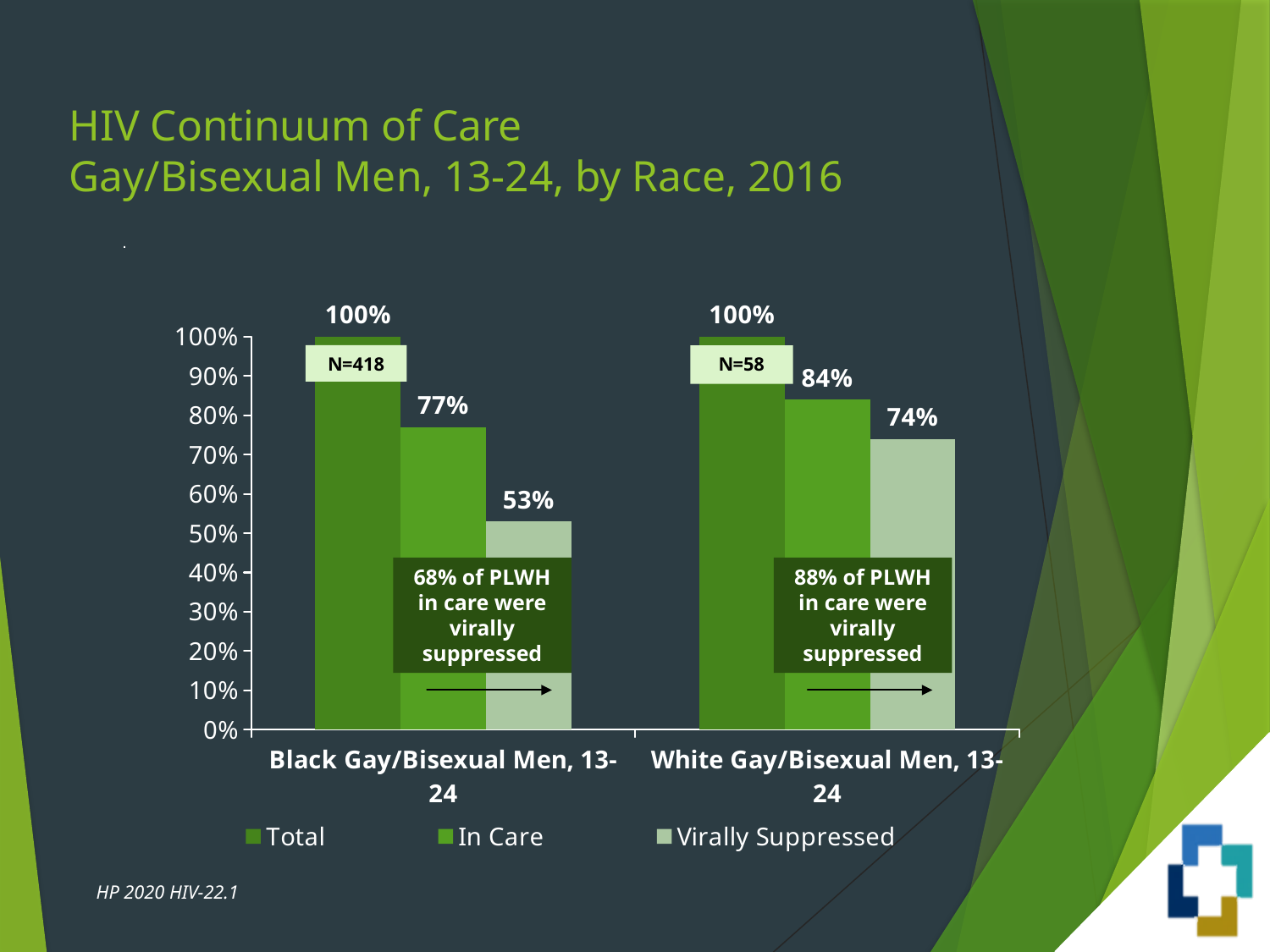
Which group has the higher Virally Suppressed value, Black or White Gay/Bisexual Men, 13-24? White Gay/Bisexual Men, 13-24 What is the N shown for Black Gay/Bisexual Men, 13-24? N=418 How many series does the legend list? 3 What is the In Care value for White Gay/Bisexual Men, 13-24? 84% What is the In Care value for Black Gay/Bisexual Men, 13-24? 77% What is the difference between the In Care values for White and Black Gay/Bisexual Men, 13-24? 7% How many categories are shown on the x axis? 2 According to the annotation, what percentage of PLWH in care were virally suppressed among White Gay/Bisexual Men, 13-24? 88% What kind of chart is shown on the slide? Bar chart What is the difference between the In Care and Virally Suppressed values for Black Gay/Bisexual Men, 13-24? 24% What is the Virally Suppressed value for White Gay/Bisexual Men, 13-24? 74% What is the Virally Suppressed value for Black Gay/Bisexual Men, 13-24? 53%